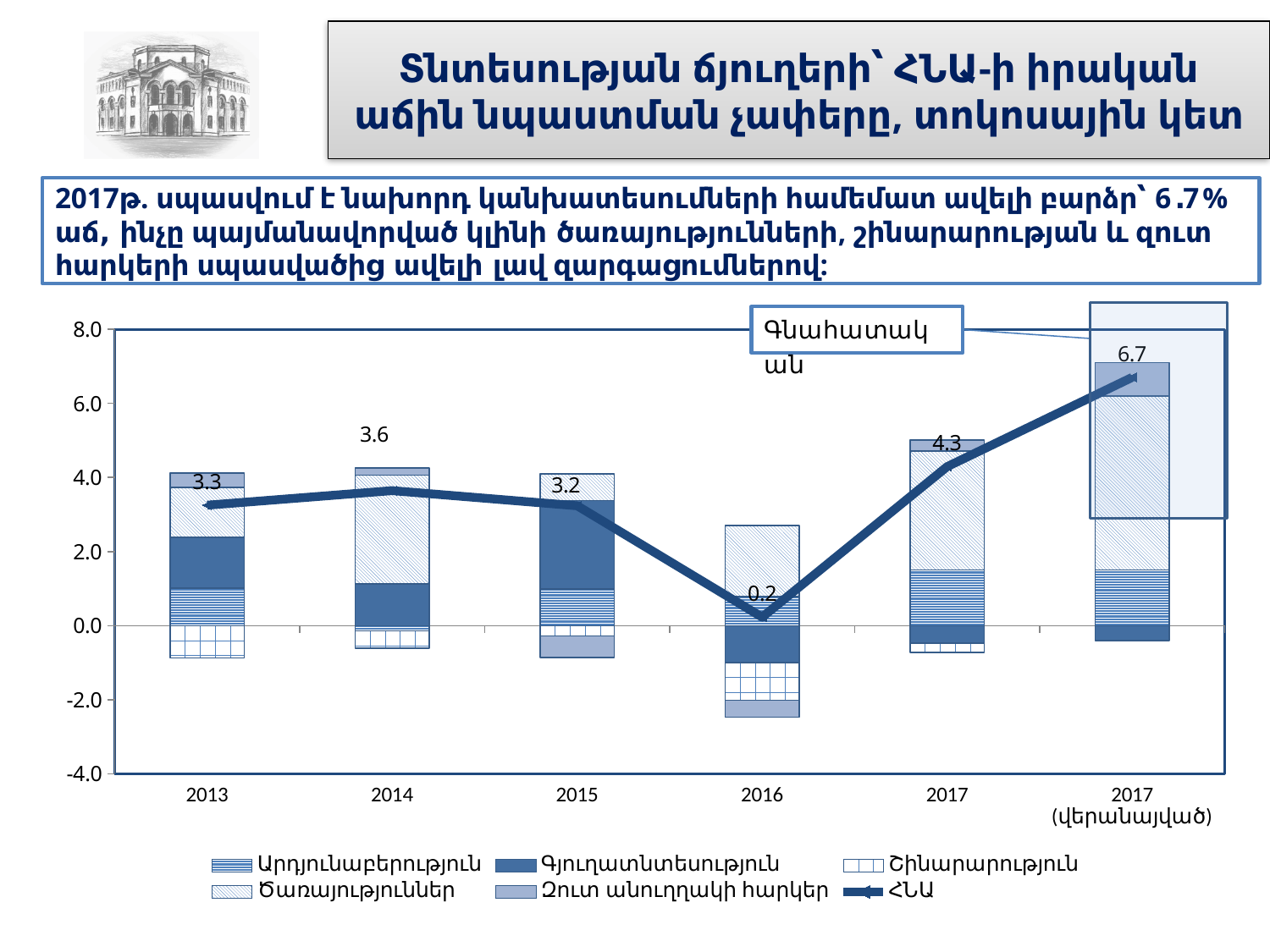
Which year has the highest ՀՆԱ value on the line? 2017 (վերանայված) What is the difference between the ՀՆԱ values for 2014 and 2013? 0.3 Does the ՀՆԱ line rise or fall from 2016 to 2017 (վերանայված)? Rise What is the ՀՆԱ value shown for 2017 (վերանայված)? 6.7 What is the difference between the ՀՆԱ values for 2017 (վերանայված) and 2017? 2.4 What is the ՀՆԱ value shown for 2013? 3.3 What kind of chart is shown on the slide? Stacked bar chart with a line How many year categories are shown on the x axis? 6 How many series does the legend list? 6 What is the ՀՆԱ value shown for 2016? 0.2 Which is larger, the ՀՆԱ value for 2014 or for 2015? 2014 Which year has the lowest ՀՆԱ value on the line? 2016